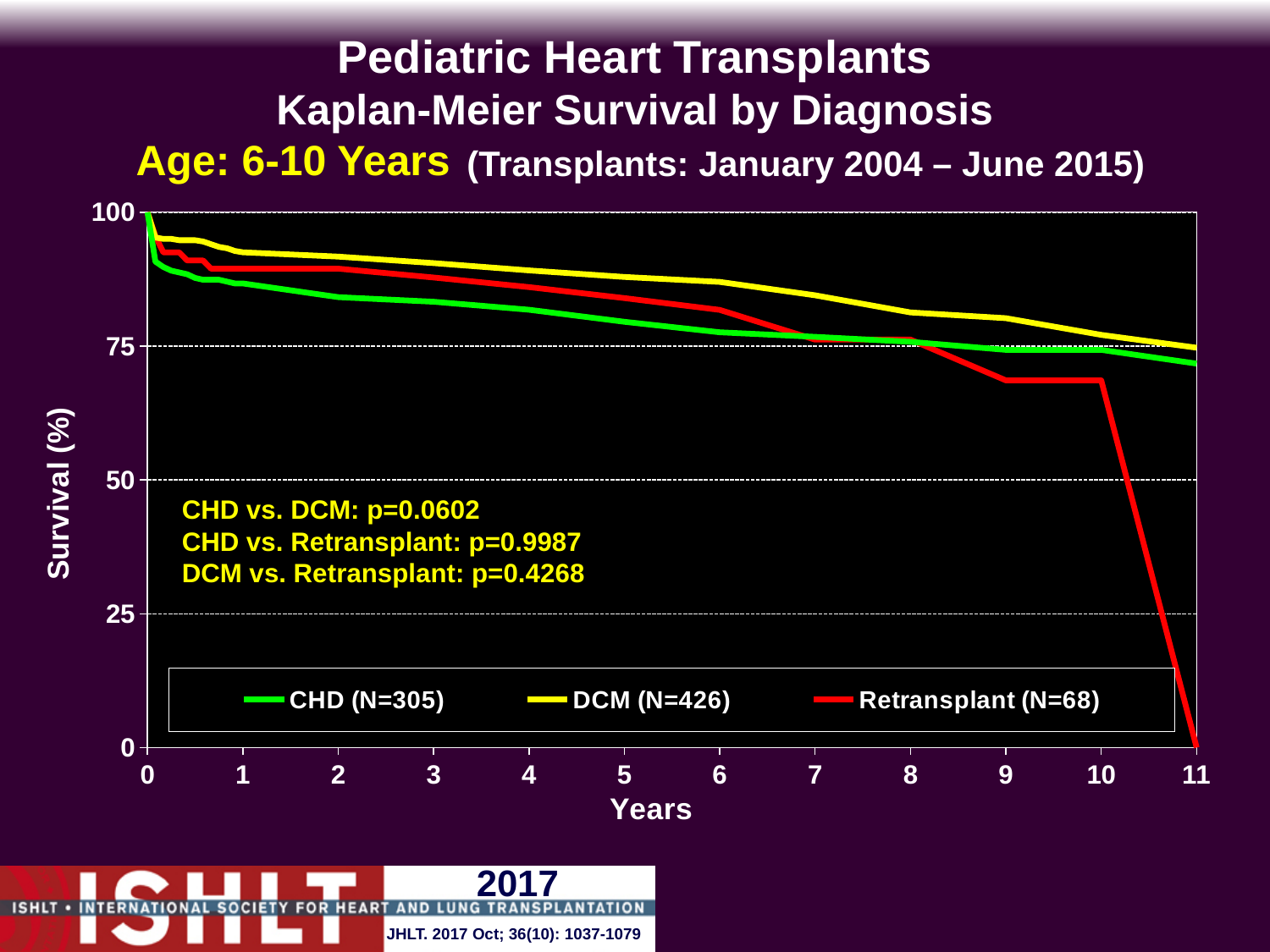
What is the N for the DCM group shown in the legend? 426 Is the survival value for Retransplant at 9 years greater or less than 75? less At 5 years, which series has higher survival, DCM or CHD? DCM Do the survival curves rise or fall as years increase? Fall Is the survival value for DCM at 5 years greater or less than 75? greater Is the survival value for Retransplant at 11 years greater or less than 25? less What is the p-value for CHD vs. DCM shown on the chart? p=0.0602 What is the p-value for DCM vs. Retransplant shown on the chart? p=0.4268 What is the N for the Retransplant group shown in the legend? 68 At 9 years, which series has higher survival, DCM or Retransplant? DCM What kind of chart is shown on the slide? Line chart How many series does the legend list? 3